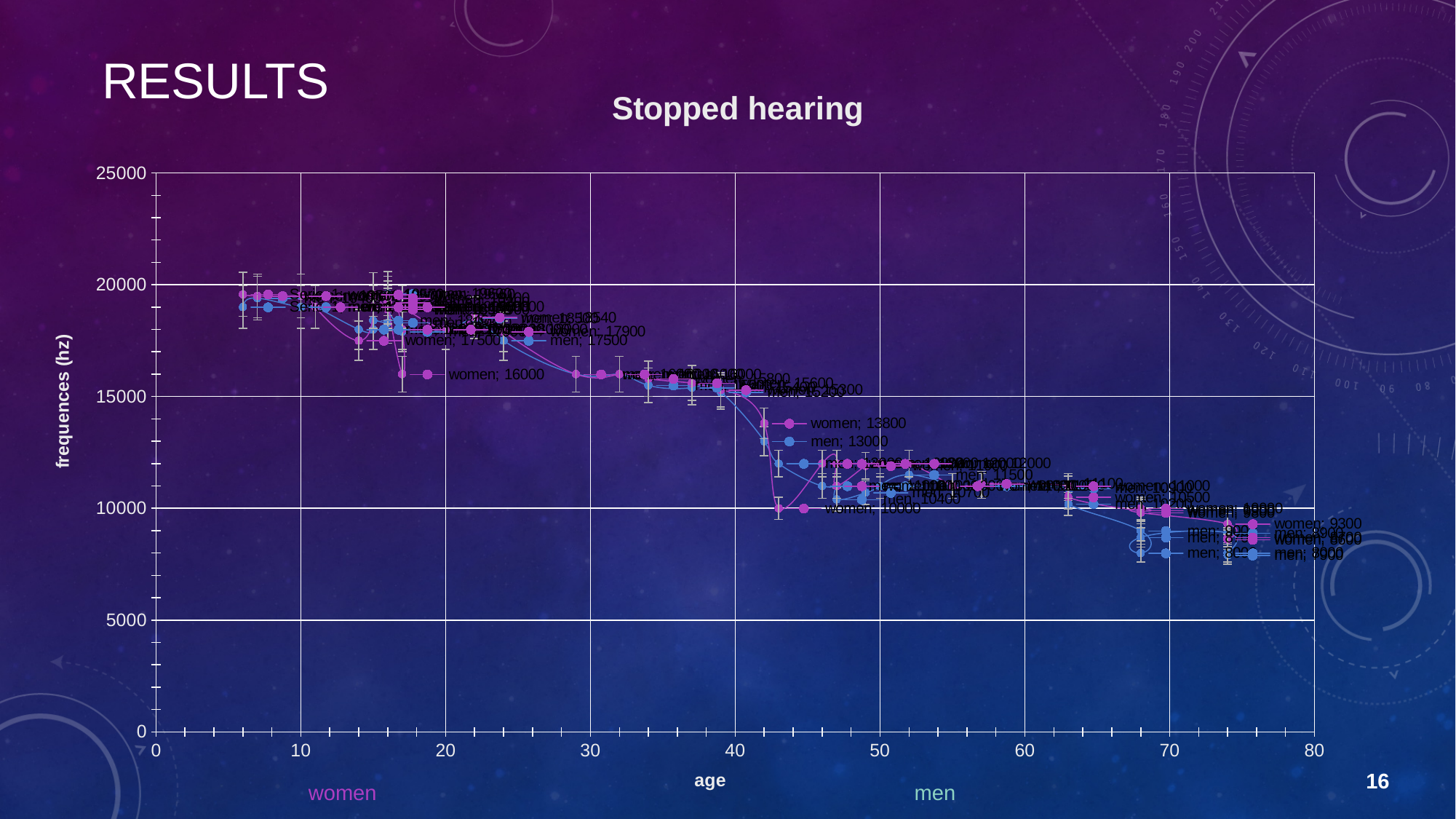
What is the difference between the women's 13800 value and the men's 13000 value at about age 44? 800 What is the title of the chart? Stopped hearing Is the frequency value for men at around age 75 greater or less than 10000? less What frequency value is labelled for women at the far right of the chart, around age 76? 9300 What is the label of the y axis? frequences (hz) What frequency value is labelled for women at about age 19, the isolated point below the cluster? 16000 What kind of chart is shown on the slide? line chart What frequency value is labelled for men at about age 44, just below the women's 13800 label? 13000 What frequency value is labelled for women at about age 44, just above the men's 13000 label? 13800 Is the frequency value for the youngest participants (around age 6) greater or less than 15000? greater Do the frequency values rise or fall as age increases along the x axis? fall How many series does the chart show? 2